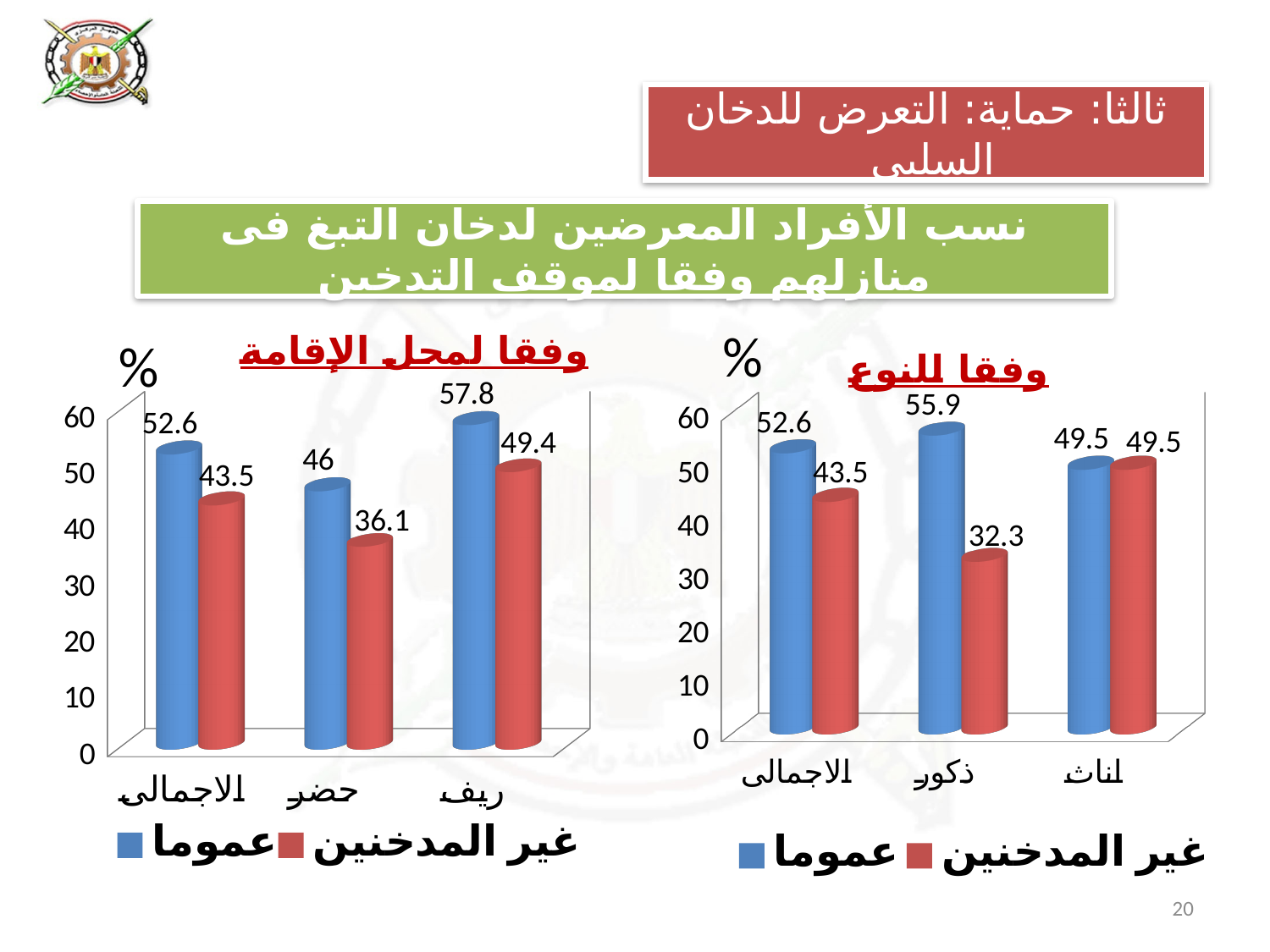
In the chart titled "وفقا لمحل الإقامة", what is the difference between the عموما and غير المدخنين values for الاجمالي? 9.1 What kind of chart is the chart titled "وفقا لمحل الإقامة"? Bar chart In the chart titled "وفقا للنوع", what is the difference between the عموما and غير المدخنين values for ذكور? 23.6 In the chart titled "وفقا للنوع", which category has the lowest value in the غير المدخنين series? ذكور How many series does the legend of the chart titled "وفقا للنوع" list? 2 In the chart titled "وفقا لمحل الإقامة", which category has the highest value in the عموما series? ريف In the chart titled "وفقا لمحل الإقامة", what is the value for ريف in the عموما series? 57.8 In the chart titled "وفقا للنوع", what is the value for إناث in the عموما series? 49.5 In the chart titled "وفقا للنوع", which is larger for ذكور: the عموما value or the غير المدخنين value? عموما In the chart titled "وفقا لمحل الإقامة", what is the value for حضر in the غير المدخنين series? 36.1 In the chart titled "وفقا لمحل الإقامة", which category has the lowest value in the غير المدخنين series? حضر In the chart titled "وفقا للنوع", what is the value for ذكور in the غير المدخنين series? 32.3